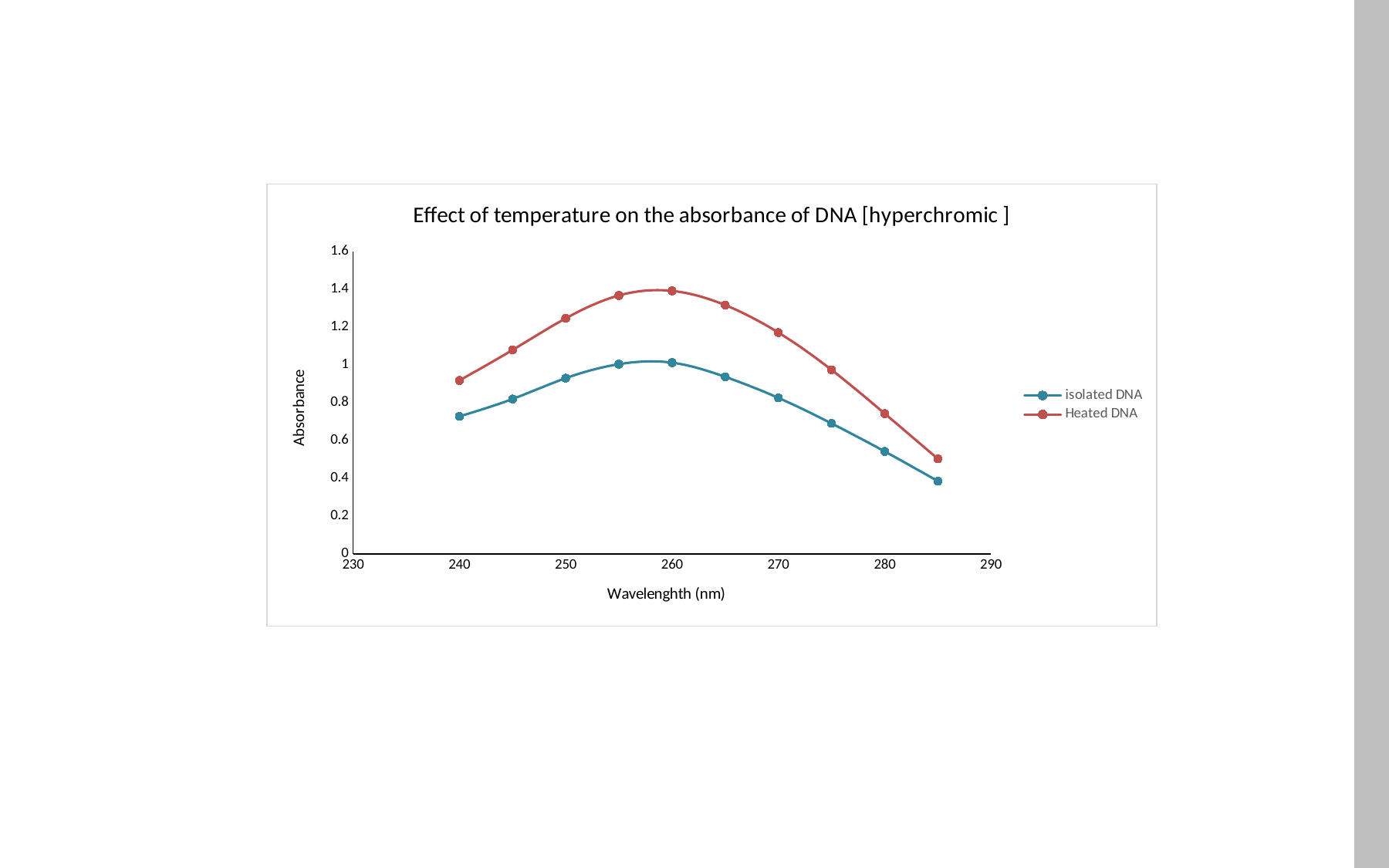
What is the title of the chart? Effect of temperature on the absorbance of DNA [hyperchromic ] At 260 nm, which series has the higher absorbance, isolated DNA or Heated DNA? Heated DNA At which wavelength is the absorbance of isolated DNA lowest? 285 Is the absorbance of Heated DNA at 285 nm greater or less than 0.6? less What is the label of the y axis? Absorbance How many data points are plotted for the Heated DNA series? 10 At which wavelength is the absorbance of Heated DNA lowest? 285 What kind of chart is shown on the slide? line chart How many series does the legend list? 2 Is the absorbance of Heated DNA at 260 nm greater or less than 1.2? greater Is the absorbance of isolated DNA at 240 nm greater or less than 0.8? less Does the absorbance of isolated DNA rise or fall between 260 nm and 285 nm? fall